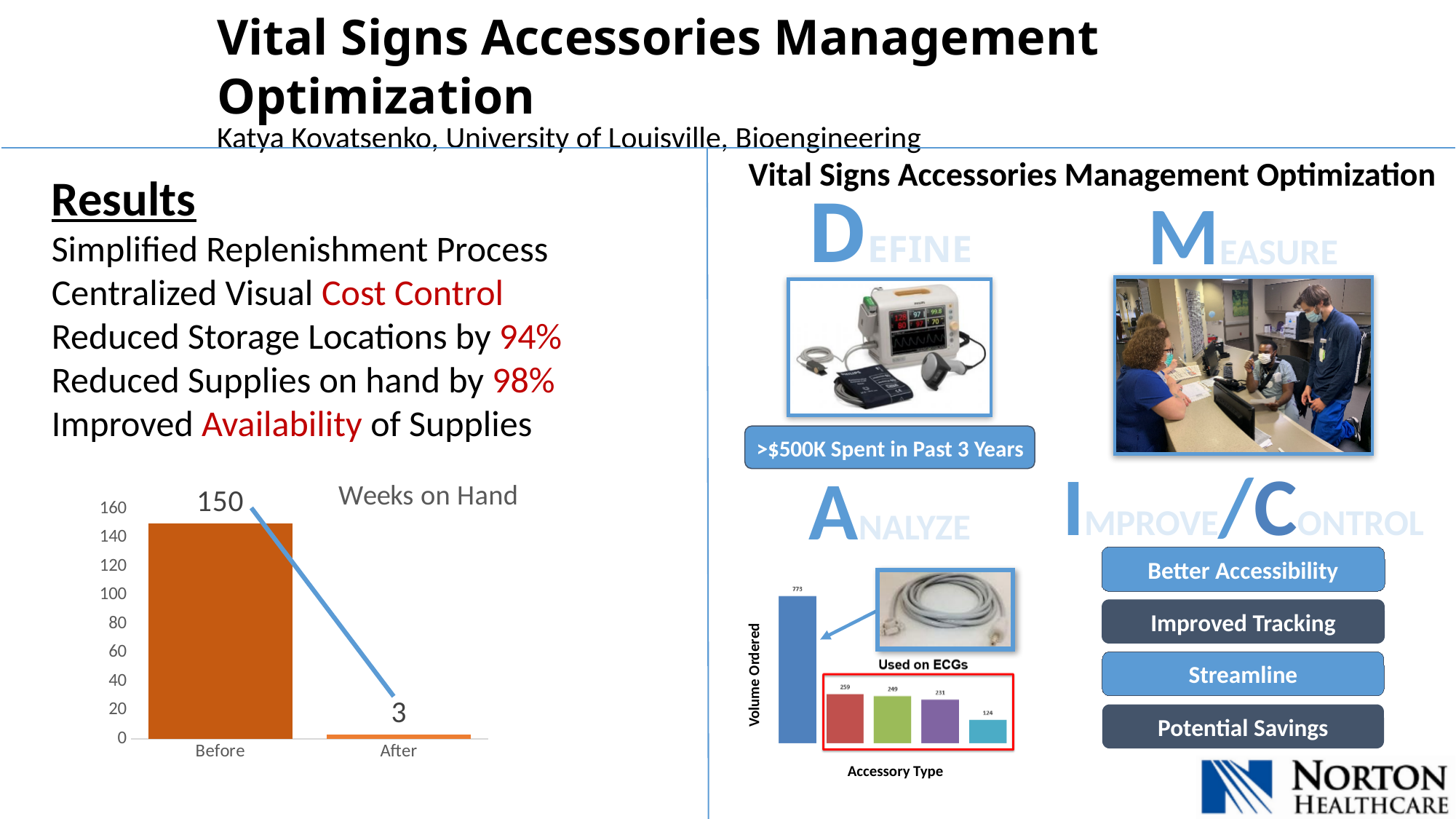
What kind of chart is the Weeks on Hand chart? bar chart In the Weeks on Hand chart, is the value for Before greater or less than 140? greater In the Volume Ordered chart on the right side of the slide, what is the value of the tallest bar? 773 In the Weeks on Hand chart, which category has the lowest value? After In the Weeks on Hand chart, do the values rise or fall from Before to After? fall In the Volume Ordered chart on the right side of the slide, how many bars are shown? 5 In the Weeks on Hand chart, what is the value for Before? 150 In the Weeks on Hand chart, what is the value for After? 3 In the Weeks on Hand chart, what is the difference between the Before and After values? 147 In the Weeks on Hand chart, which category has the higher value? Before In the Volume Ordered chart on the right side of the slide, what is the value of the shortest bar? 124 In the Weeks on Hand chart, how many categories are shown on the x axis? 2